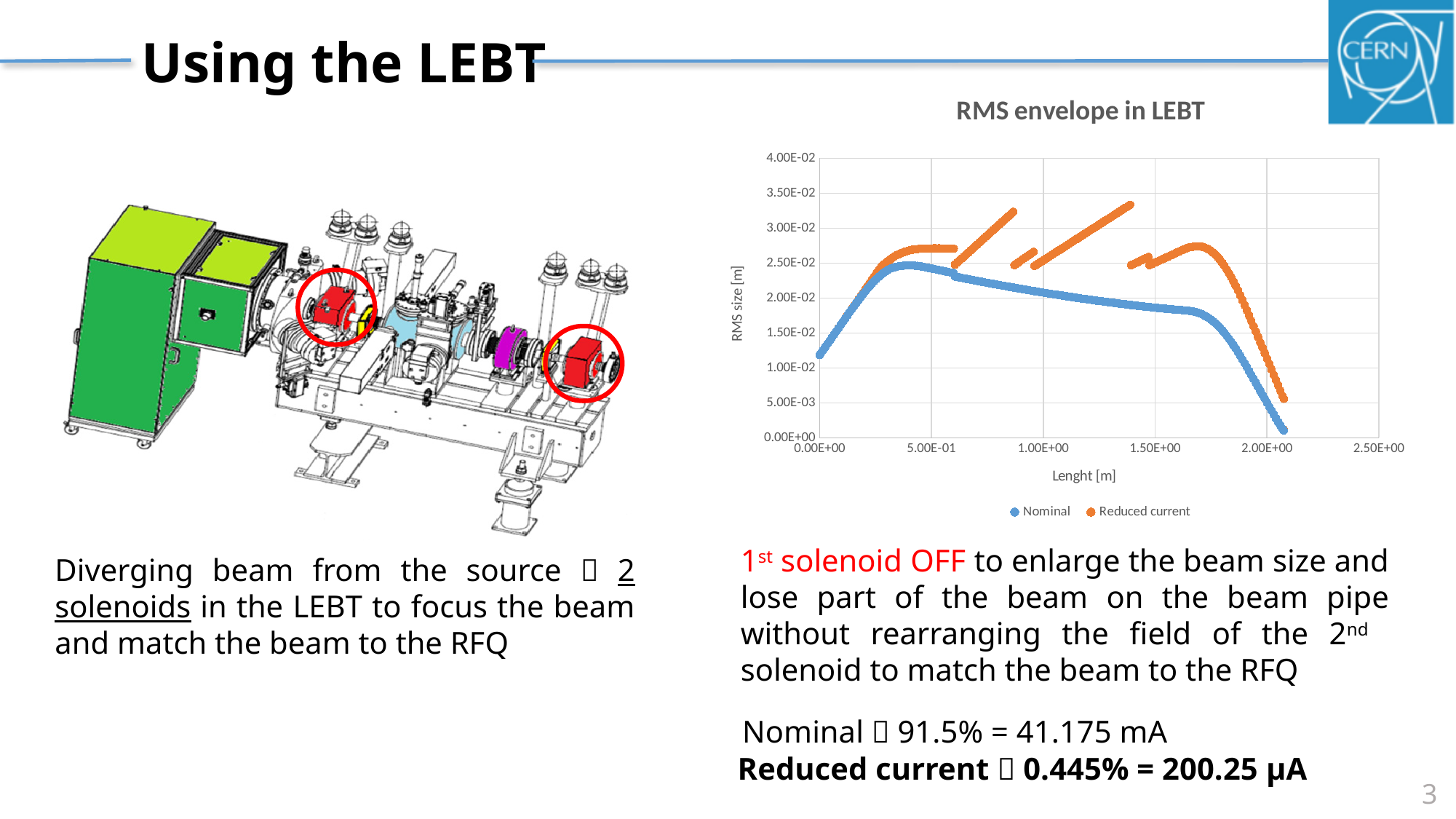
In the 'RMS envelope in LEBT' chart, at length 1.00E+00, which series has the larger RMS size, Nominal or Reduced current? Reduced current What kind of chart is the 'RMS envelope in LEBT' chart? scatter chart What are the two series named in the legend of the 'RMS envelope in LEBT' chart? Nominal and Reduced current What is the label of the x axis of the 'RMS envelope in LEBT' chart? Lenght [m] In the 'RMS envelope in LEBT' chart, is the peak value of the Nominal series greater or less than 2.00E-02? greater In the 'RMS envelope in LEBT' chart, does the Nominal series rise or fall between lengths 1.50E+00 and 2.00E+00? fall In the 'RMS envelope in LEBT' chart, which series reaches the higher maximum RMS size, Nominal or Reduced current? Reduced current In the 'RMS envelope in LEBT' chart, does the Nominal series rise or fall between lengths 0.00E+00 and about 4.00E-01? rise How many series does the legend of the 'RMS envelope in LEBT' chart list? 2 In the 'RMS envelope in LEBT' chart, is the Nominal RMS size at length 0.00E+00 greater or less than 1.00E-02? greater In the 'RMS envelope in LEBT' chart, is the highest value of the Reduced current series greater or less than 3.00E-02? greater